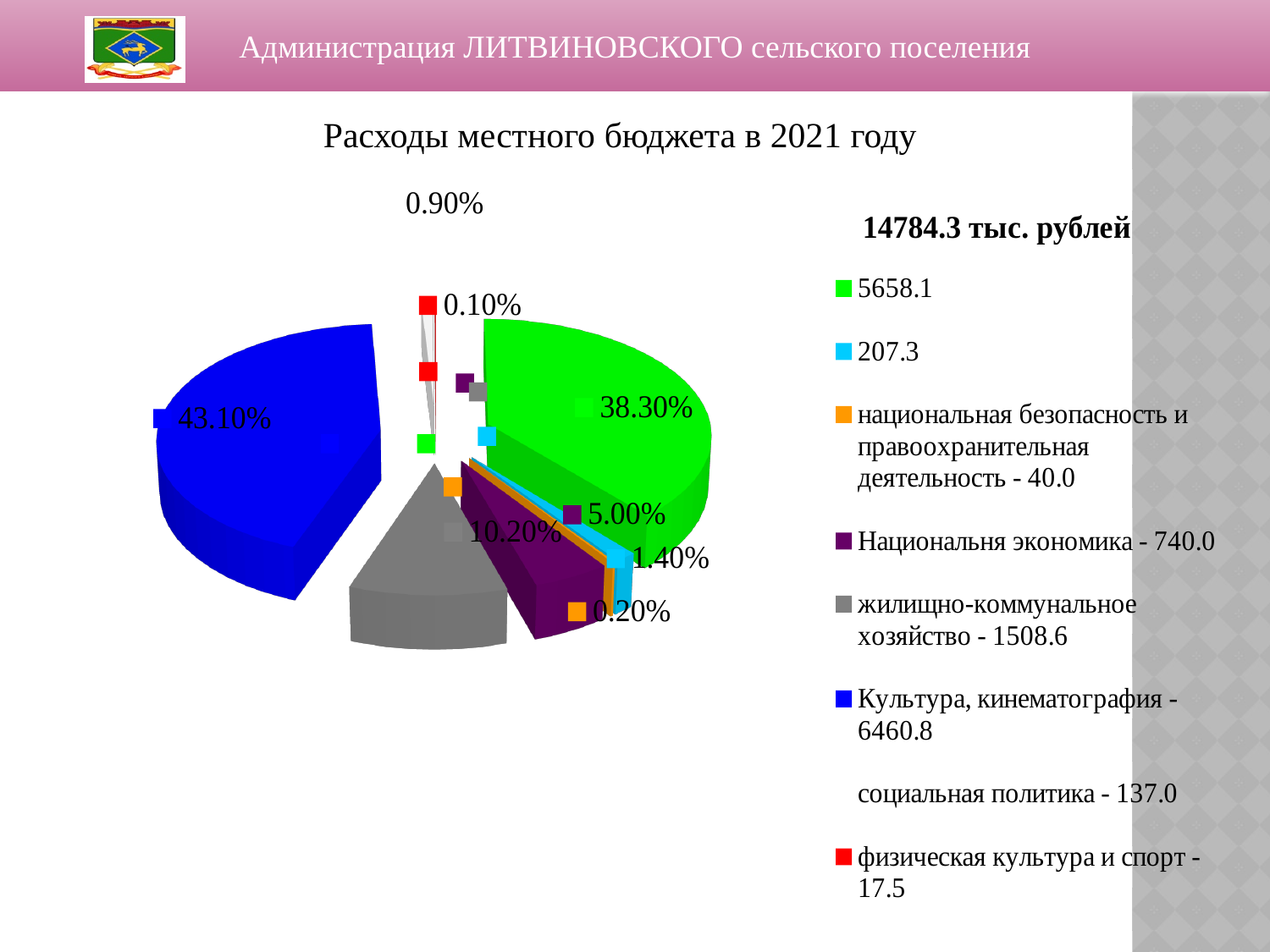
What amount is listed in the legend for жилищно-коммунальное хозяйство? 1508.6 Which legend category has the largest share of the pie? Культура, кинематография What is the title of the chart? 14784.3 тыс. рублей How many slices does the pie chart have? 8 Which slice is larger: the green slice (38.30%) or the gray slice (10.20%)? the green slice What percentage share is shown for the gray slice (жилищно-коммунальное хозяйство)? 10.20% How many entries does the legend list? 8 What is the difference in percentage points between the blue slice (43.10%) and the green slice (38.30%)? 4.80% What percentage share is shown for the purple slice (Национальня экономика)? 5.00% Which legend category has the smallest share of the pie? физическая культура и спорт What kind of chart is shown on the slide? pie chart What percentage share is shown for the blue slice (Культура, кинематография)? 43.10%